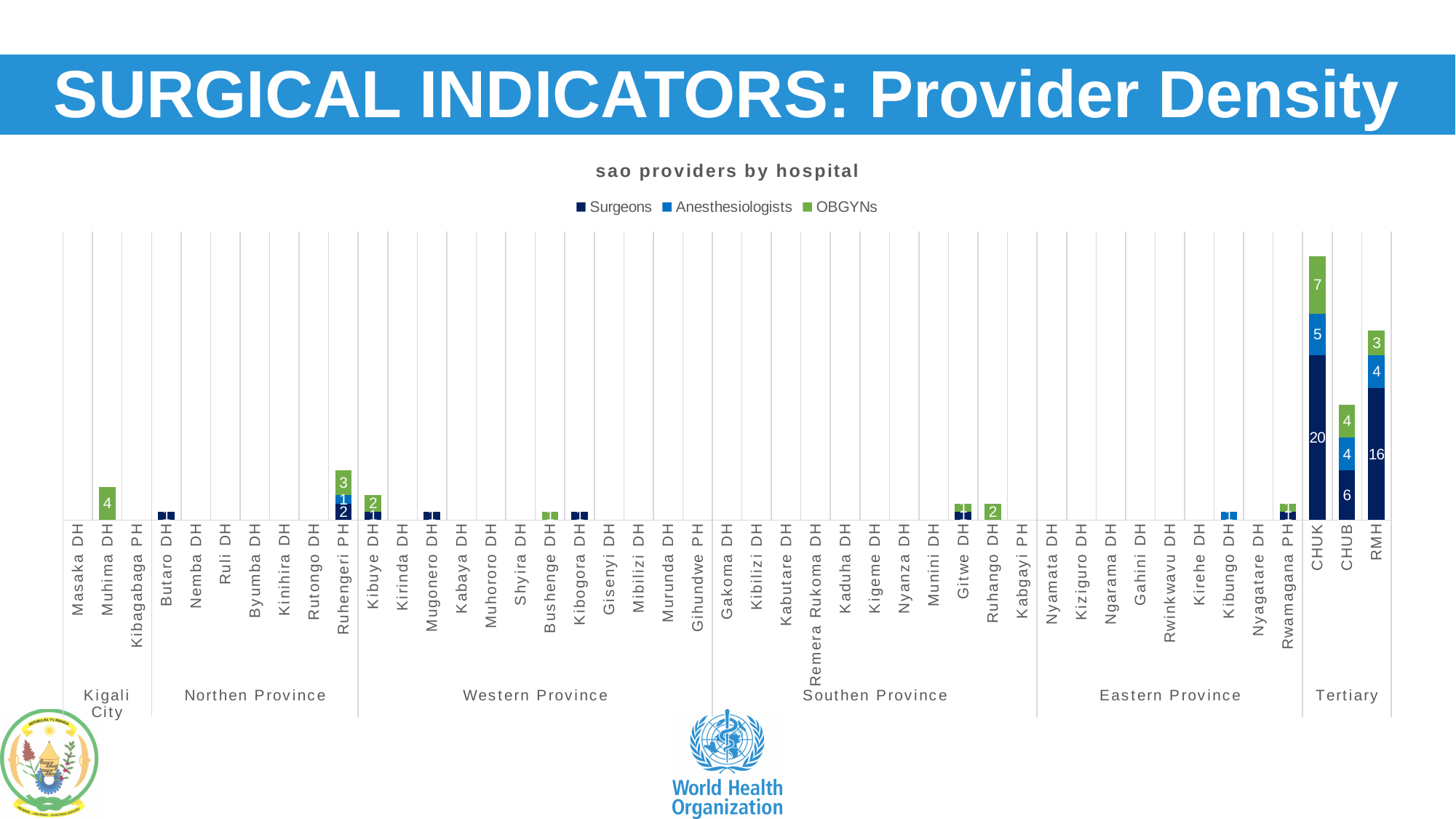
What is the difference between the number of Surgeons at CHUK and at RMH? 4 Which has more Surgeons, CHUB or RMH? RMH What is the total number of providers at Ruhengeri PH? 6 How many Anesthesiologists does CHUB have? 4 How many OBGYNs does Muhima DH have? 4 Which hospital has the highest total number of providers? CHUK How many Surgeons does CHUK have? 20 What is the total number of providers at CHUK? 32 How many OBGYNs does RMH have? 3 What kind of chart is shown on the slide? stacked bar chart What is the title of the chart? sao providers by hospital How many series does the legend list? 3